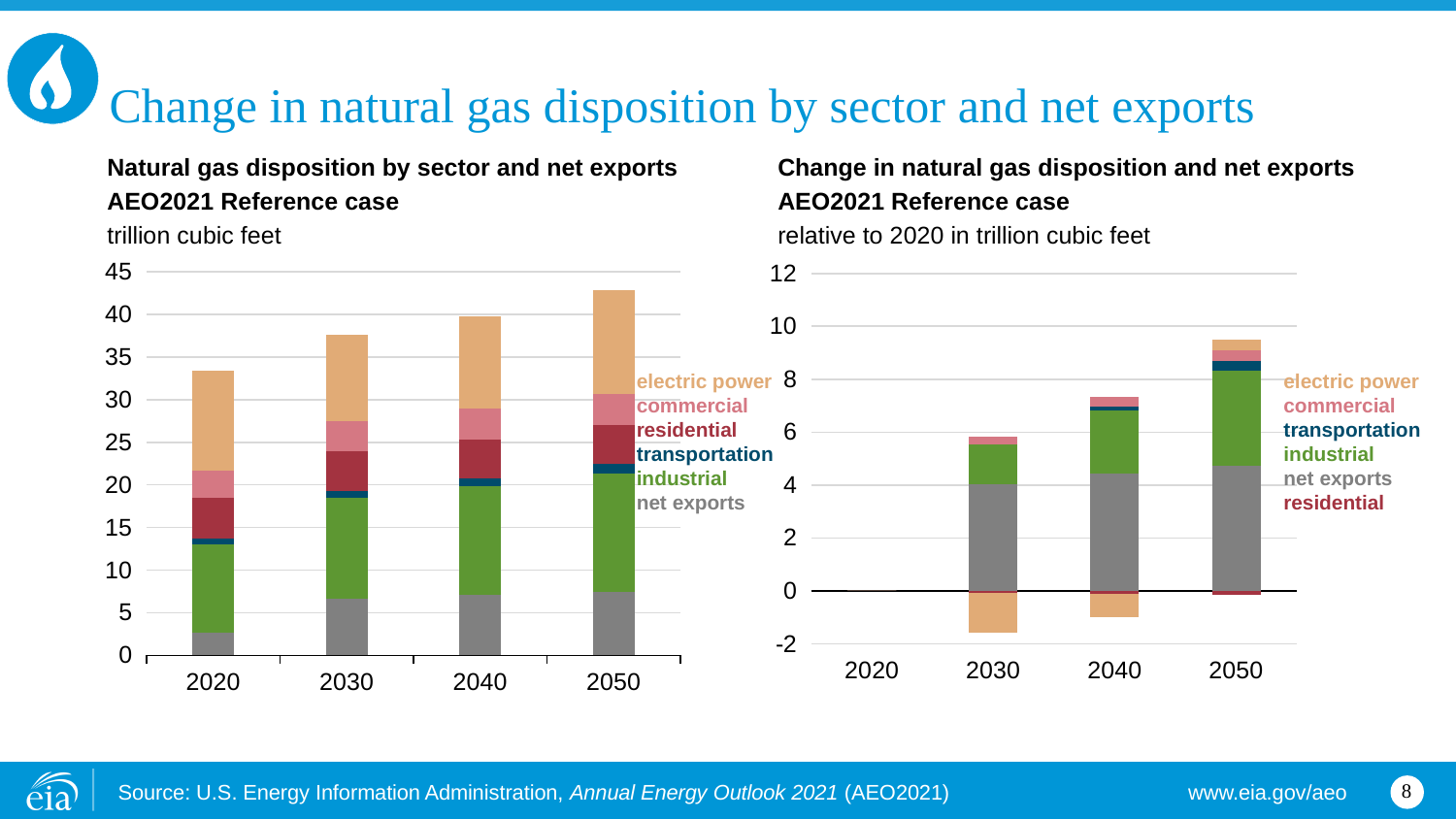
In the right chart, 'Change in natural gas disposition and net exports', which year has the largest positive stacked bar? 2050 What kind of chart is the left chart, 'Natural gas disposition by sector and net exports'? Stacked bar chart In the left chart, 'Natural gas disposition by sector and net exports', is the total for 2050 greater or less than 40? greater What unit is given below the title of the left chart, 'Natural gas disposition by sector and net exports'? trillion cubic feet How many years are shown on the x axis of the left chart, 'Natural gas disposition by sector and net exports'? 4 In the left chart, 'Natural gas disposition by sector and net exports', is the total for 2020 greater or less than 35? less In the right chart, 'Change in natural gas disposition and net exports', is the positive stacked total for 2050 greater or less than 8? greater How many series does the legend of the left chart, 'Natural gas disposition by sector and net exports', list? 6 In the right chart, 'Change in natural gas disposition and net exports', which series is listed last in the legend? residential In the left chart, 'Natural gas disposition by sector and net exports', which year has the tallest stacked bar? 2050 In the left chart, 'Natural gas disposition by sector and net exports', do the total bar heights rise or fall from 2020 to 2050? Rise